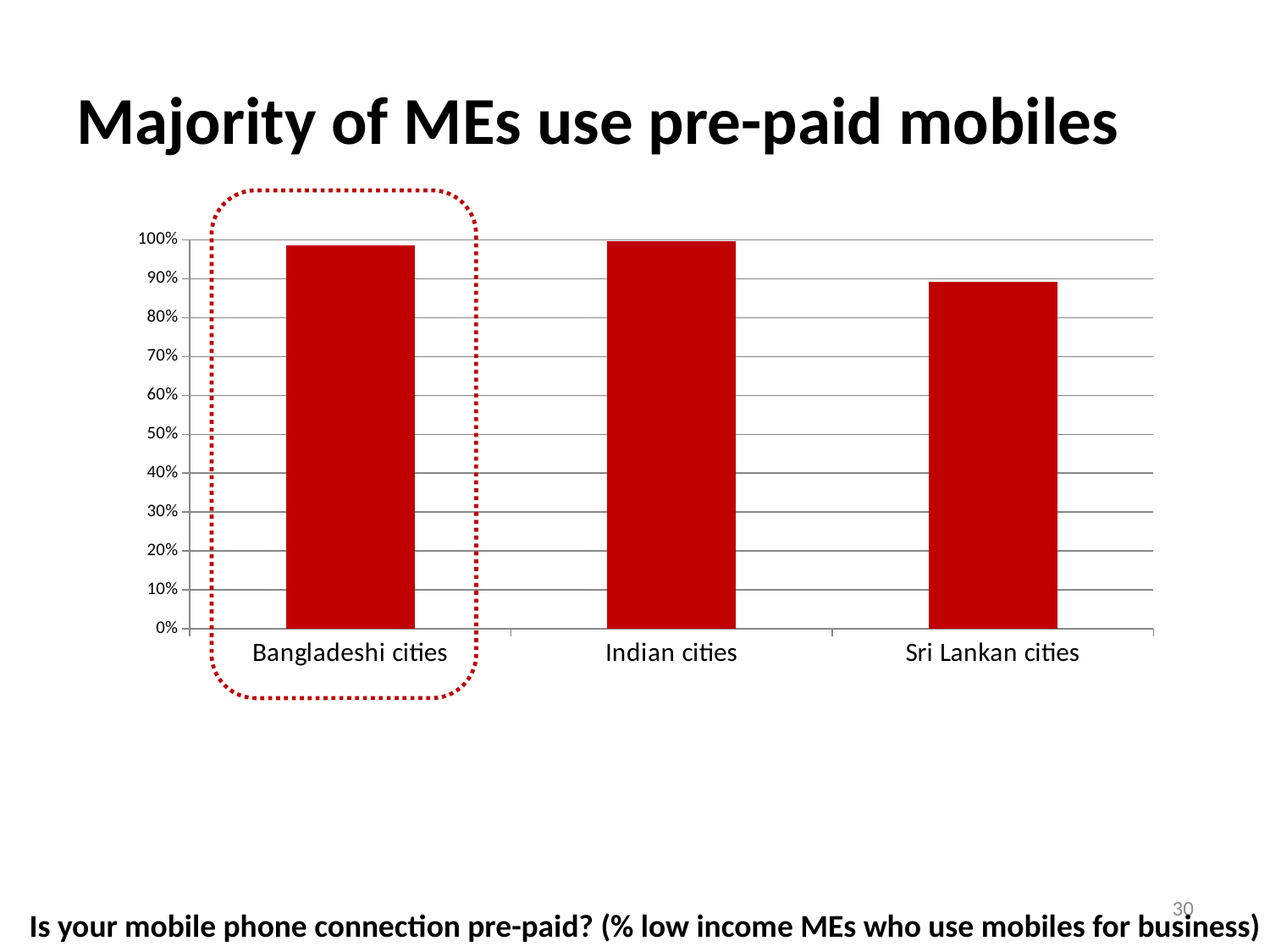
How many categories are plotted in the chart? 3 What kind of chart is shown on the slide? bar chart Which category's bar is enclosed by a red dotted outline? Bangladeshi cities Which is larger, the value for Indian cities or the value for Sri Lankan cities? Indian cities Is the value for Indian cities greater or less than 90%? greater Is the value for Bangladeshi cities greater or less than 90%? greater Which is larger, the value for Bangladeshi cities or the value for Sri Lankan cities? Bangladeshi cities Which category has the lowest value in the chart? Sri Lankan cities What is the title of the slide containing the chart? Majority of MEs use pre-paid mobiles Is the value for Sri Lankan cities greater or less than 80%? greater